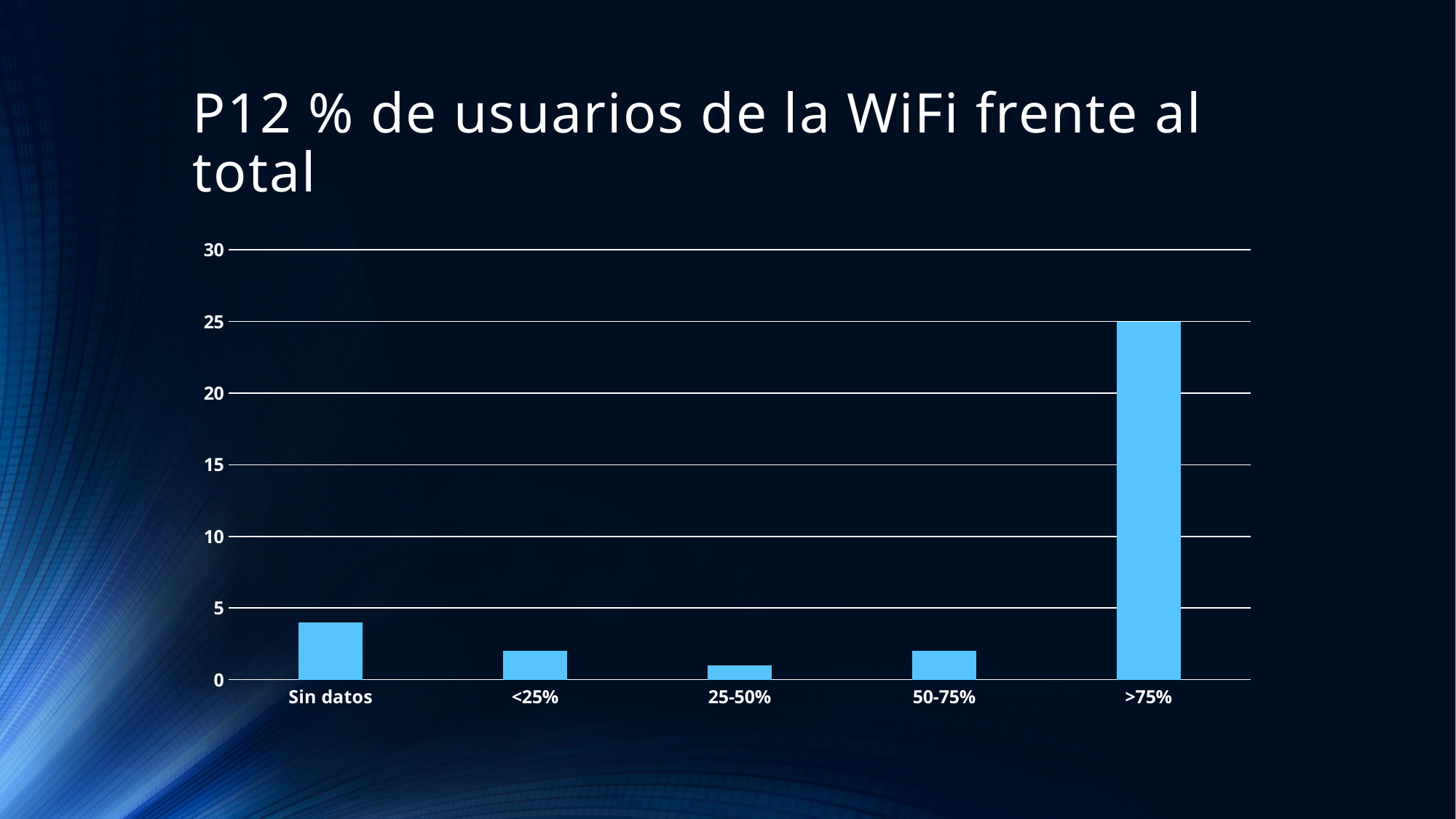
How many categories are shown on the x axis of the chart? 5 Which is larger, the value for >75% or the value for 50-75%? >75% Is the value for 25-50% greater or less than 5? less Which category has the lowest value in the chart? 25-50% What kind of chart is shown on the slide? Bar chart Which category has the highest value in the chart? >75% What is the value for the >75% category? 25 Is the value for Sin datos greater or less than 5? less What is the title of the slide containing the chart? P12 % de usuarios de la WiFi frente al total Is the value for >75% greater or less than 20? greater What is the highest value shown on the y axis of the chart? 30 Which is larger, the value for Sin datos or the value for <25%? Sin datos